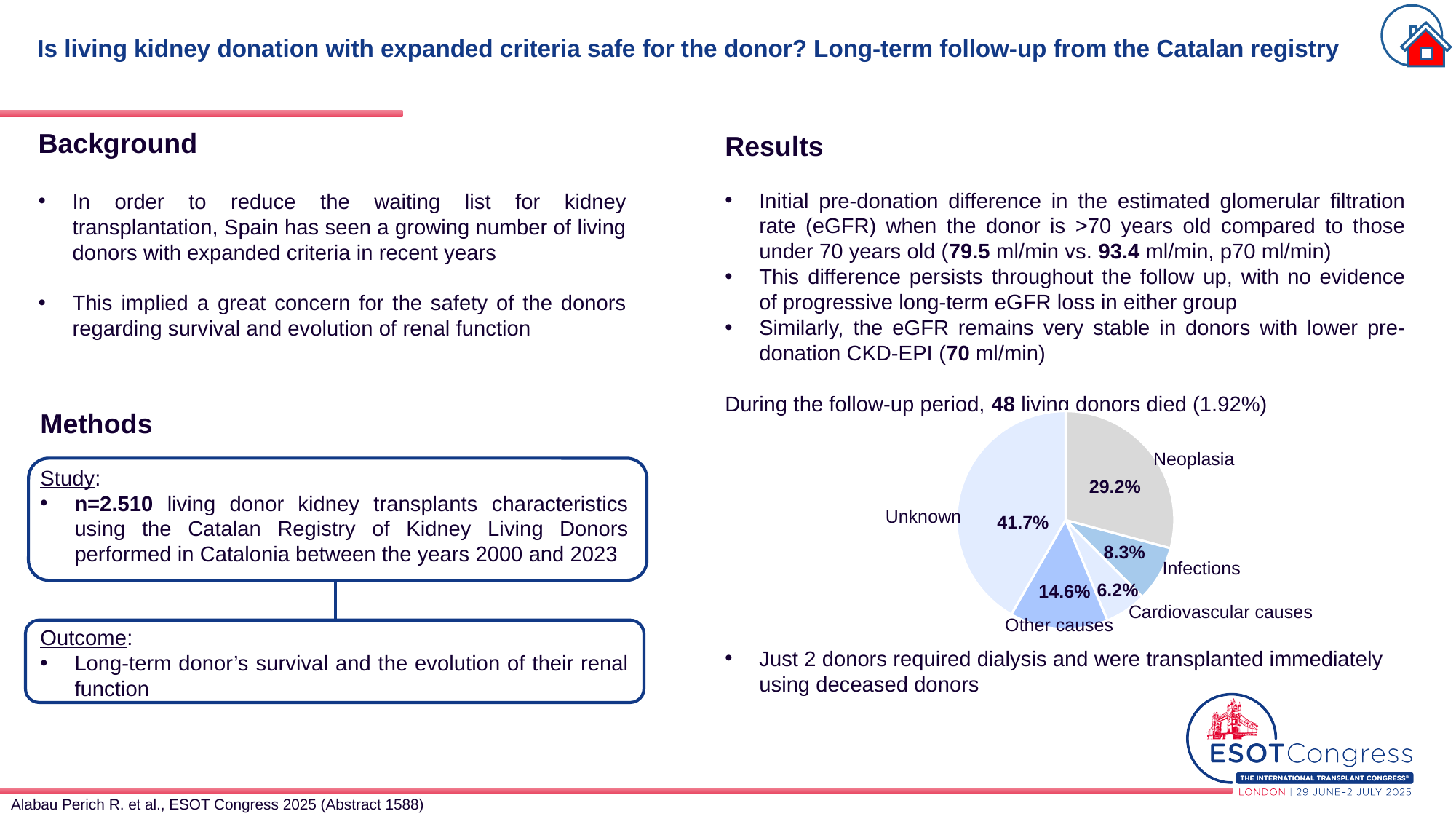
What is the difference in percentage points between the Unknown and Neoplasia slices? 12.5 What type of chart is shown on the slide? Pie chart Which slice is larger, Infections or Other causes? Other causes Which cause of death has the largest share in the pie chart? Unknown What percentage of the pie chart is labelled Unknown? 41.7% How many slices does the pie chart have? 5 What percentage of the pie chart is labelled Infections? 8.3% What percentage of the pie chart is labelled Cardiovascular causes? 6.2% What percentage of the pie chart is labelled Neoplasia? 29.2% Which cause of death has the smallest share in the pie chart? Cardiovascular causes What is the difference in percentage points between the Infections and Cardiovascular causes slices? 2.1 What percentage of the pie chart is labelled Other causes? 14.6%